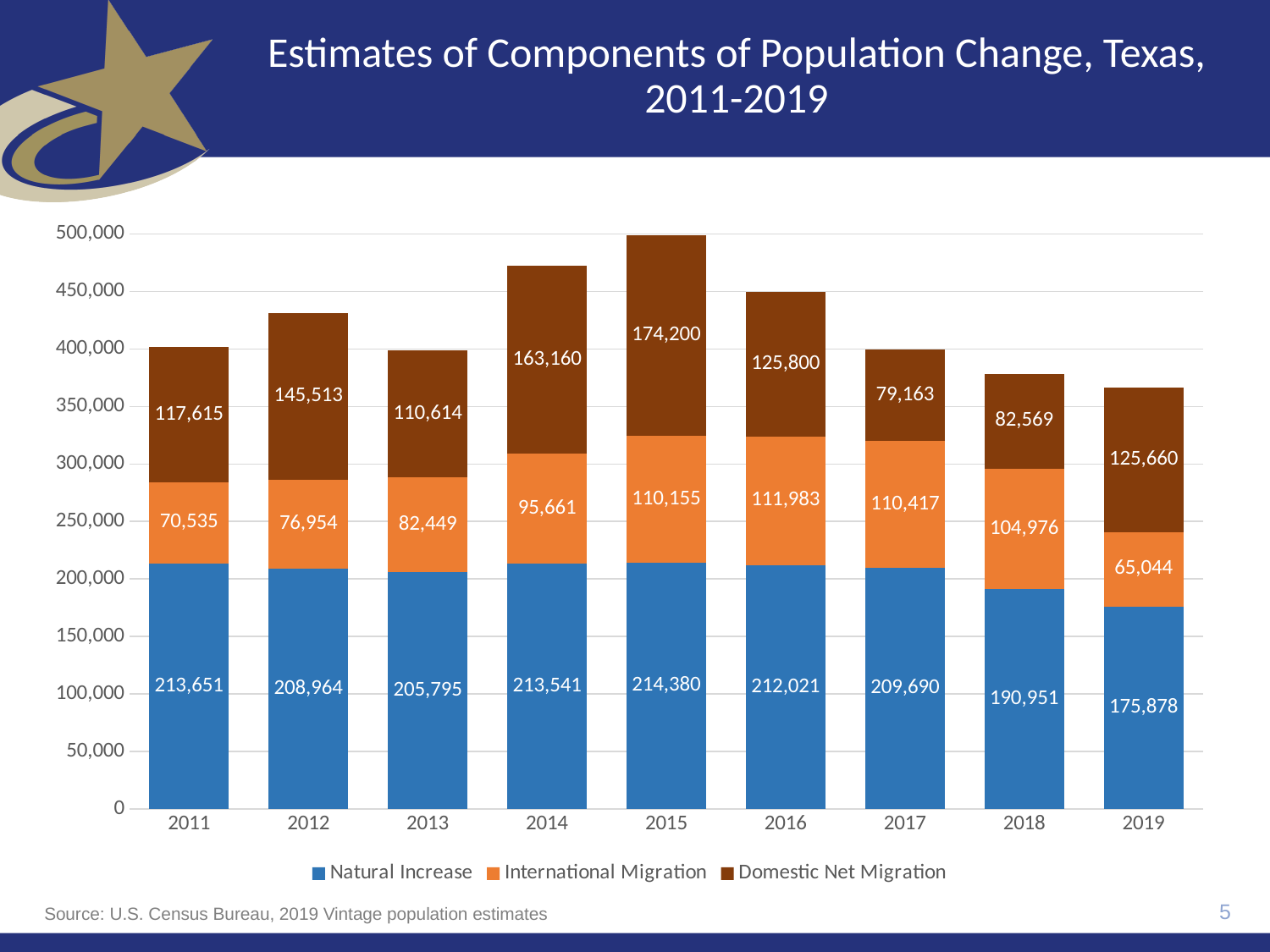
Which is larger, the International Migration value for 2016 or for 2014? 2016 How many series does the legend list? 3 What is the total of the stacked bar for 2019? 366,582 How many years are shown on the x axis? 9 Which year has the highest Domestic Net Migration value? 2015 What is the Natural Increase value for 2015? 214,380 What is the International Migration value for 2018? 104,976 What kind of chart is shown on the slide? Stacked bar chart Which year has the lowest International Migration value? 2019 What is the Domestic Net Migration value for 2012? 145,513 What is the difference between the Domestic Net Migration values for 2015 and 2017? 95,037 Is the total of the stacked bar for 2015 greater or less than 450,000? greater